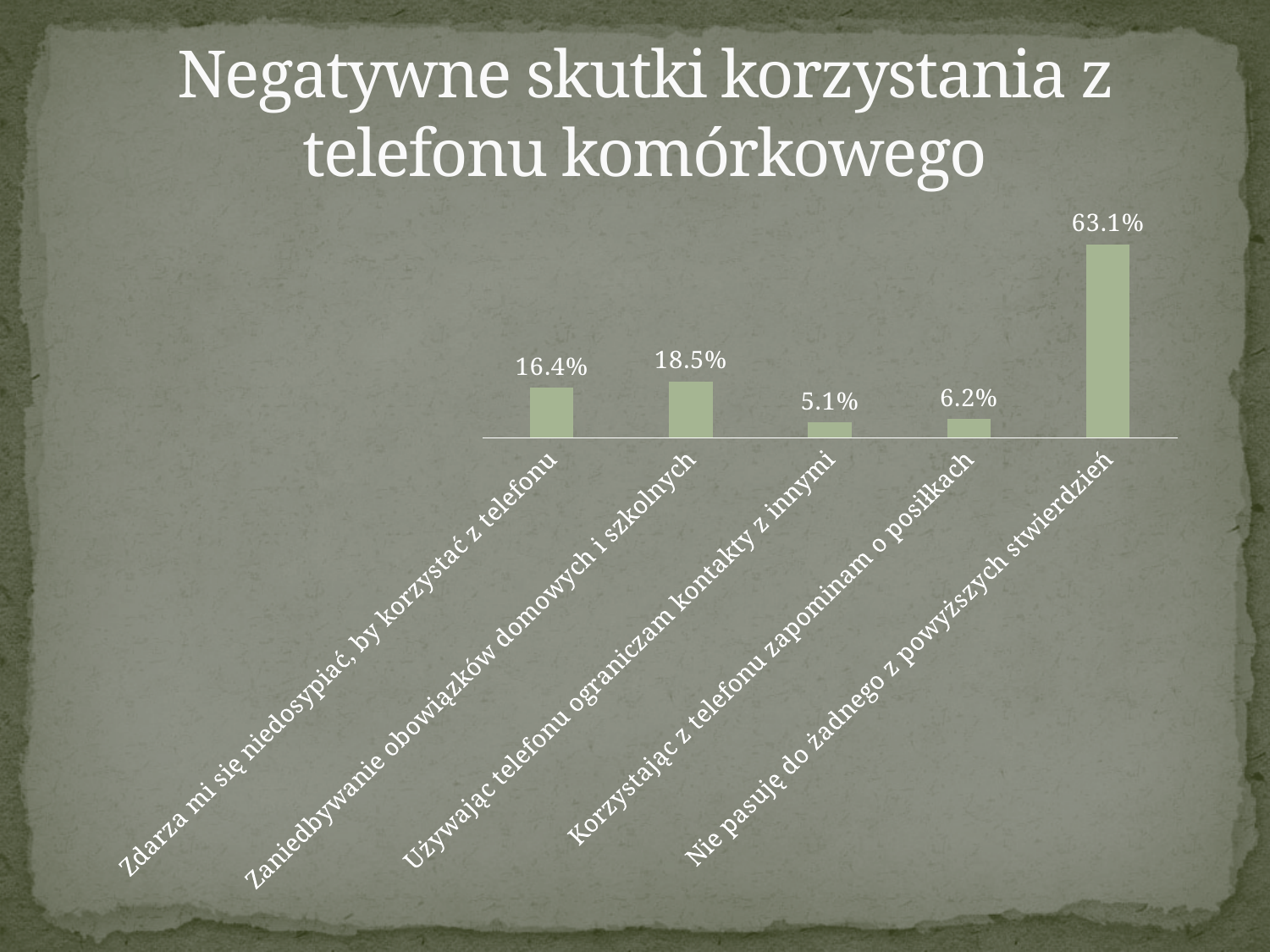
What is the value for "Nie pasuję do żadnego z powyższych stwierdzień"? 63.1% What is the title of the slide? Negatywne skutki korzystania z telefonu komórkowego What is the value for "Korzystając z telefonu zapominam o posiłkach"? 6.2% What is the difference between the highest and lowest values in the chart? 58.0% Which category has the lowest value? Używając telefonu ograniczam kontakty z innymi What is the value for "Zdarza mi się niedosypiać, by korzystać z telefonu"? 16.4% What is the value for "Używając telefonu ograniczam kontakty z innymi"? 5.1% Which is larger: the value for "Korzystając z telefonu zapominam o posiłkach" or for "Używając telefonu ograniczam kontakty z innymi"? Korzystając z telefonu zapominam o posiłkach What is the difference between the values for "Zaniedbywanie obowiązków domowych i szkolnych" and "Zdarza mi się niedosypiać, by korzystać z telefonu"? 2.1% Which category has the highest value? Nie pasuję do żadnego z powyższych stwierdzień What kind of chart is shown on the slide? Bar chart How many categories are shown in the chart? 5